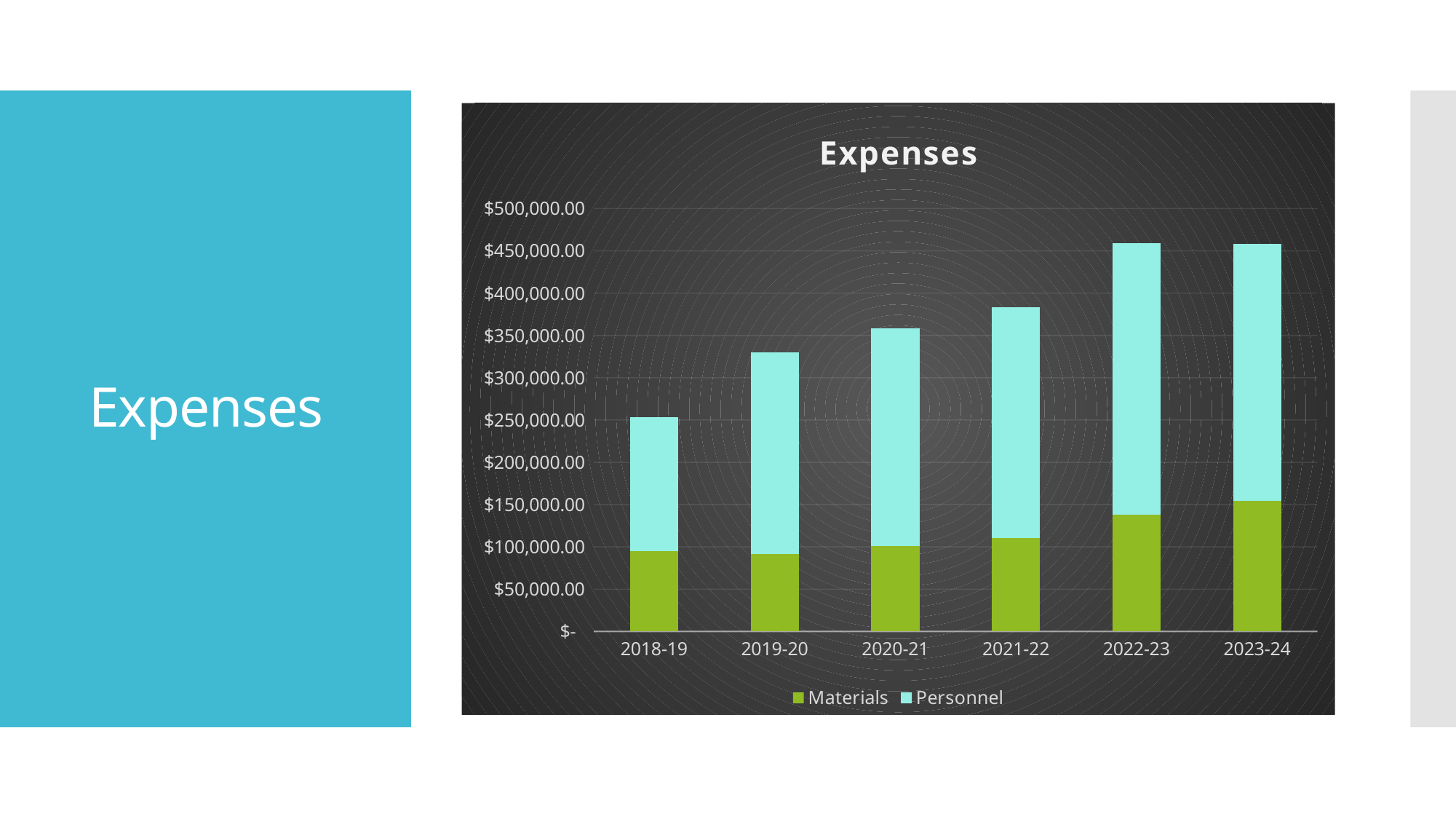
What is the title of the chart? Expenses How many series does the legend list? 2 Is the total expenses value for 2021-22 greater or less than $350,000.00? greater Which year has larger total expenses, 2019-20 or 2021-22? 2021-22 Is the Materials value for 2022-23 greater or less than $150,000.00? less Is the total expenses value for 2018-19 greater or less than $300,000.00? less How many fiscal years are shown on the x axis? 6 Which year has the lowest total expenses? 2018-19 Do total expenses generally rise or fall from 2018-19 to 2022-23? rise Which year has the highest Materials value? 2023-24 Which series is shown in green? Materials What kind of chart is shown on the slide? Stacked bar chart